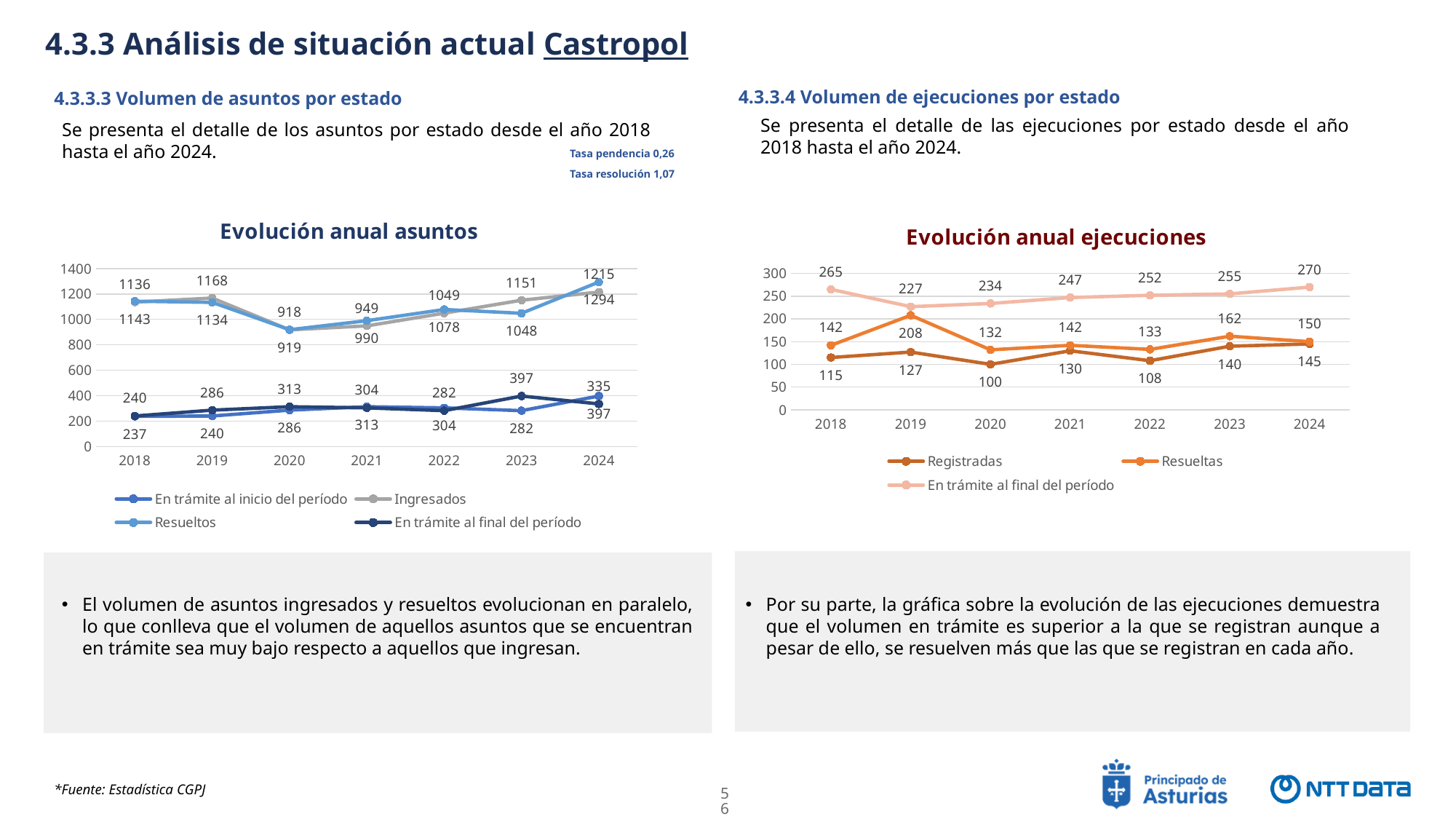
In 'Evolución anual asuntos', is the value of 'Ingresados' in 2020 greater or less than 1000? less In 'Evolución anual ejecuciones', which is larger in 2023, 'Resueltas' or 'Registradas'? Resueltas In 'Evolución anual ejecuciones', in which year is 'Resueltas' highest? 2019 In 'Evolución anual ejecuciones', what is the value of 'En trámite al final del período' in 2024? 270 How many series does the legend of 'Evolución anual asuntos' list? 4 In 'Evolución anual ejecuciones', in which year is 'Registradas' lowest? 2020 In 'Evolución anual ejecuciones', does 'En trámite al final del período' rise or fall from 2019 to 2024? rise In 'Evolución anual asuntos', what is the value of 'Ingresados' in 2019? 1168 What kind of chart is 'Evolución anual asuntos'? line chart How many years are shown on the x axis of 'Evolución anual ejecuciones'? 7 How many series does the legend of 'Evolución anual ejecuciones' list? 3 In 'Evolución anual ejecuciones', what is the difference between 'Resueltas' and 'Registradas' in 2019? 81